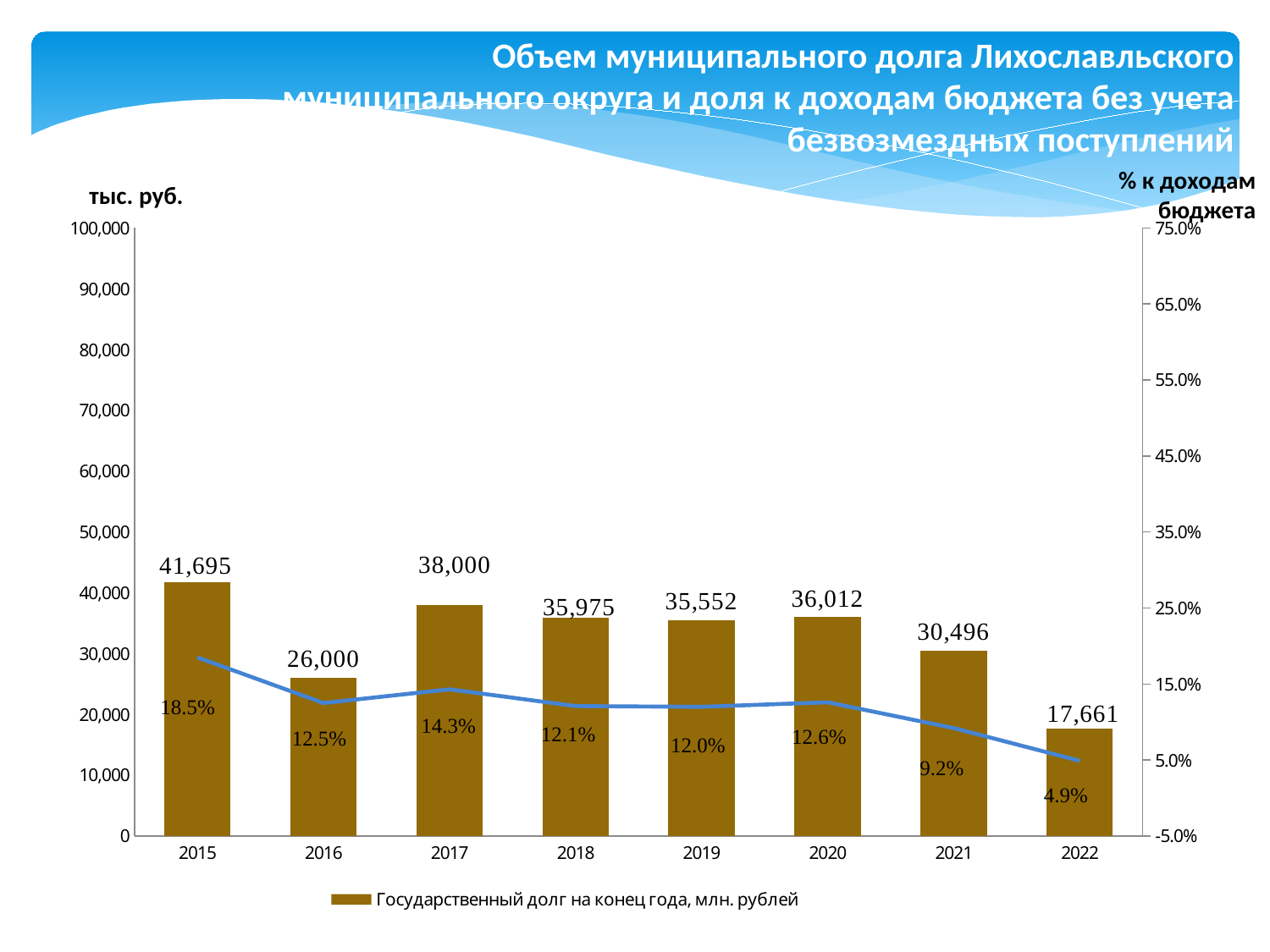
What is the unit label shown above the left axis? тыс. руб. What is the difference between the debt values for 2017 and 2016? 12,000 How many years are shown on the x axis? 8 What is the difference between the debt values for 2015 and 2022? 24,034 Which year has the lowest debt bar? 2022 What kind of chart is shown on the slide? Combination bar and line chart Which year has the highest debt bar? 2015 What percentage of budget income does the line show for 2021? 9.2% What is the debt value shown for 2022? 17,661 What is the municipal debt value shown for 2015? 41,695 Which year has a larger debt value, 2018 or 2021? 2018 Which year has the lowest percentage to budget income on the line? 2022